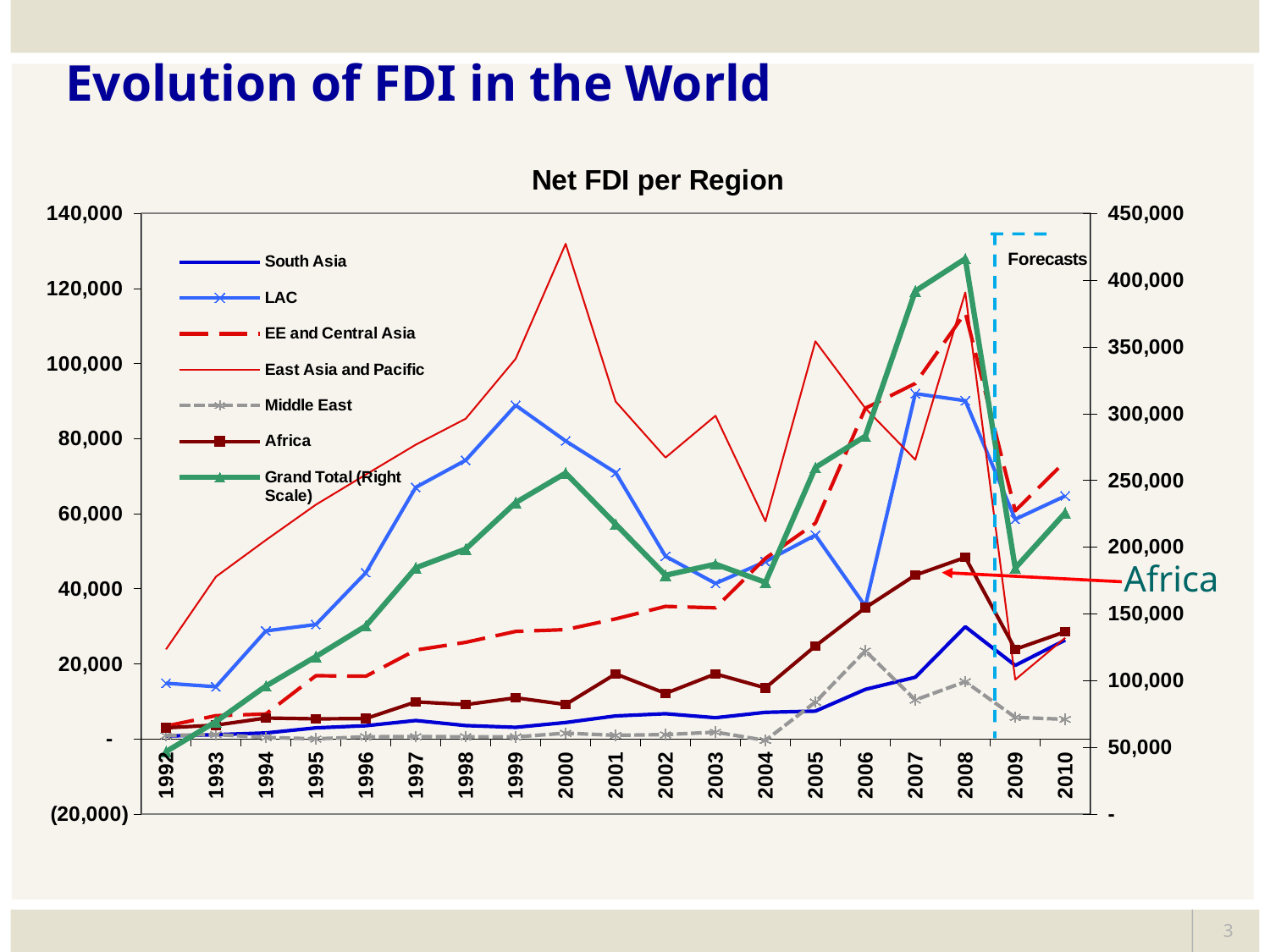
How many years are plotted along the x axis of the Net FDI per Region chart? 19 Which region has the highest value in 2000 on the left scale? East Asia and Pacific Which series is plotted on the right scale? Grand Total (Right Scale) How many series does the legend of the Net FDI per Region chart list? 7 Is the value for Africa in 2008 greater or less than 40,000? greater In 2007, which is larger: the value for LAC or the value for Africa? LAC Which region has the lowest value in 2008? Middle East Is the value for East Asia and Pacific in 2000 greater or less than 120,000? greater Does the Africa series rise or fall from 2004 to 2008? Rise Is the value for Middle East in 2006 greater or less than 40,000? less What kind of chart is shown on the slide? Line chart